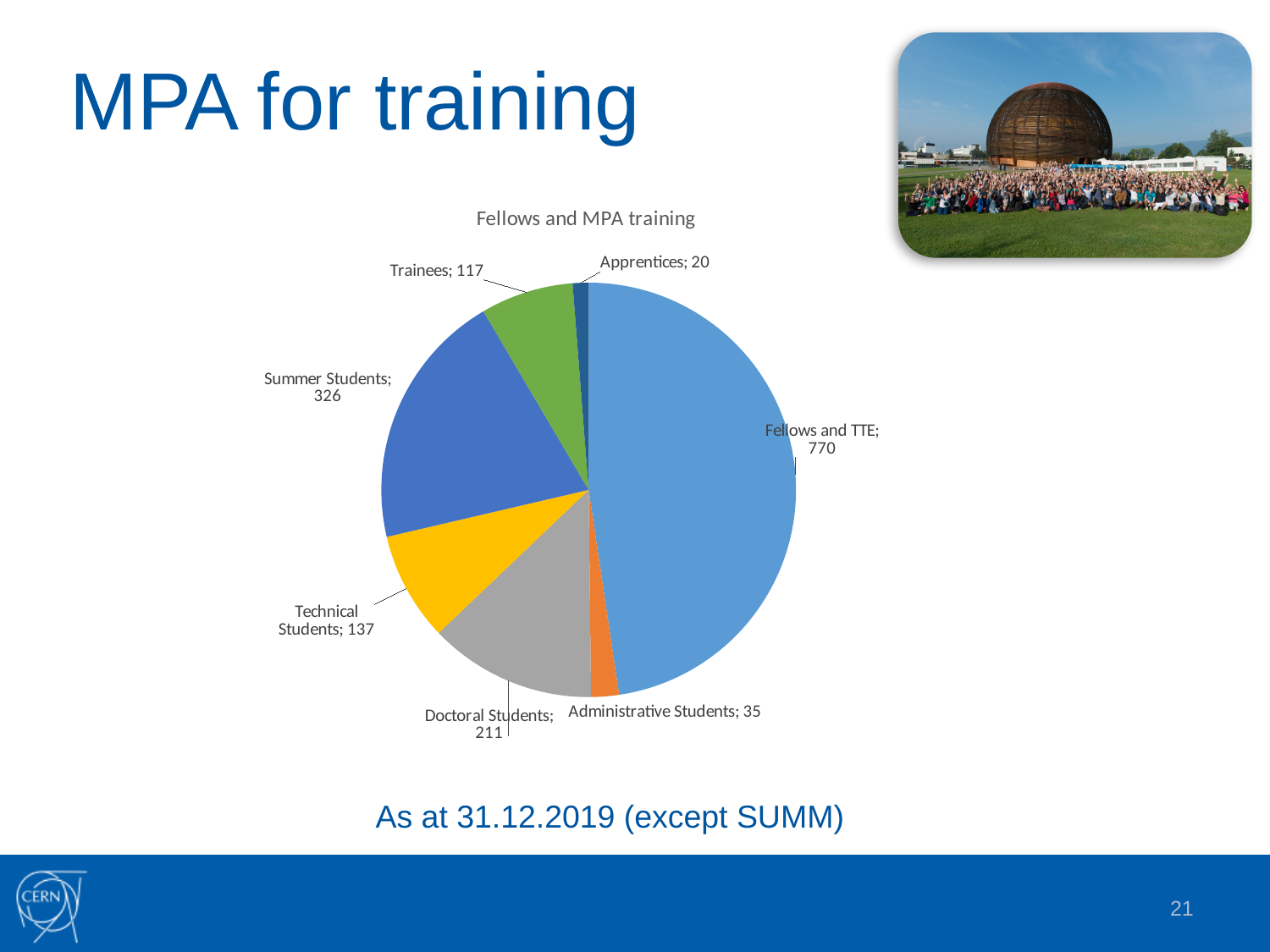
What is the title of the chart? Fellows and MPA training What is the value for Administrative Students? 35 What is the difference between Summer Students and Doctoral Students? 115 How many categories does the pie chart have? 7 What is the total of all categories in the pie chart? 1616 What type of chart is shown on the slide? pie chart What is the value for Summer Students? 326 Which category has the smallest slice? Apprentices What is the value for Fellows and TTE? 770 Which is larger, Technical Students or Trainees? Technical Students Which category has the largest slice? Fellows and TTE What is the value for Apprentices? 20